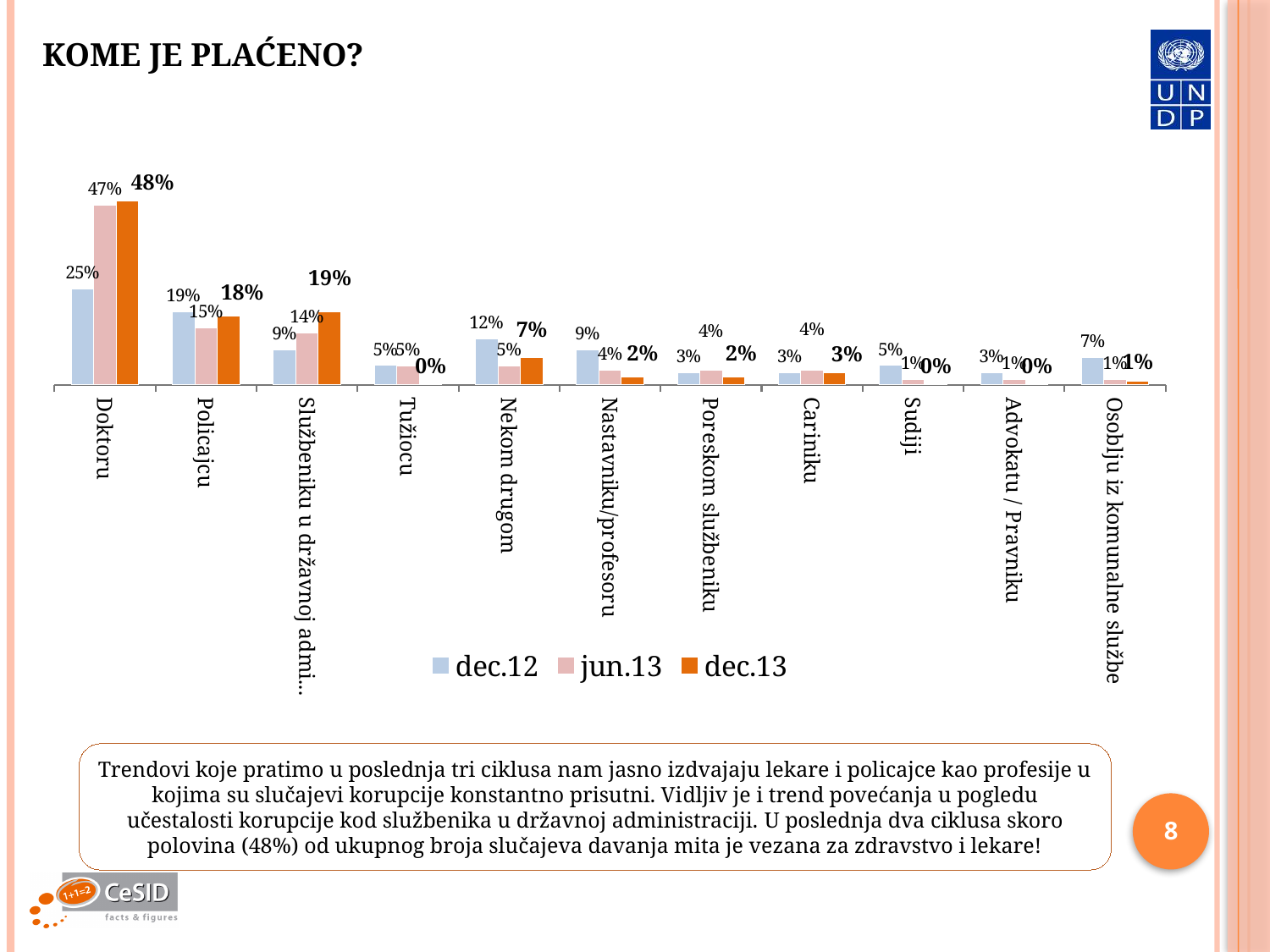
What is the dec.12 value for Nekom drugom? 12% What is the jun.13 value for Službeniku u državnoj administraciji? 14% How many categories are shown on the x axis? 11 Which is larger for Policajcu: the dec.12 value or the jun.13 value? dec.12 What kind of chart is shown on the slide? bar chart Which category has the highest dec.13 value? Doktoru What is the title of the chart? KOME JE PLAĆENO? What is the difference between the dec.13 and dec.12 values for Doktoru? 23% Do the values for Službeniku u državnoj administraciji rise or fall from dec.12 to dec.13? rise How many series does the legend list? 3 What is the dec.13 value for Tužiocu? 0% What is the dec.13 value for Doktoru? 48%